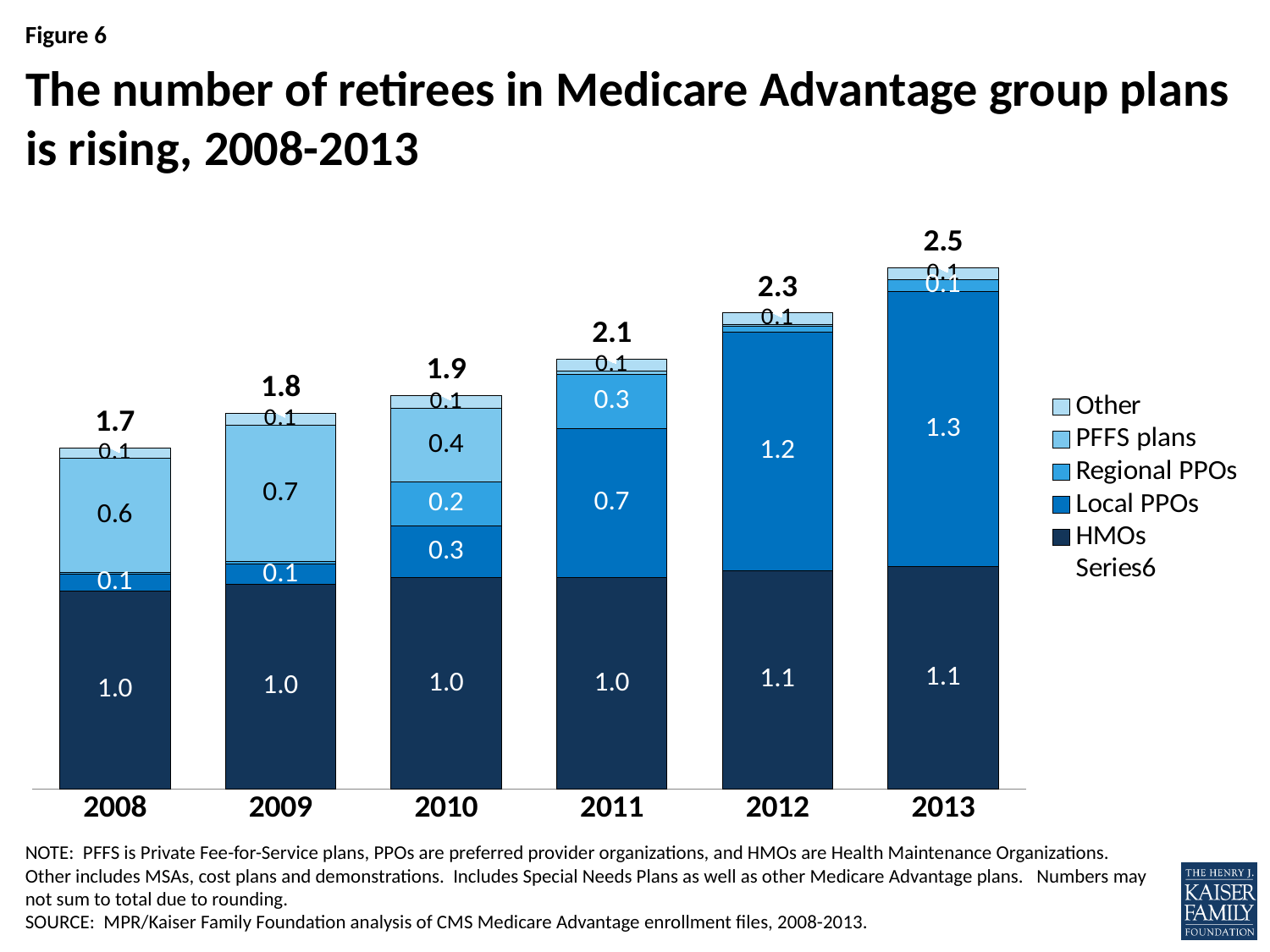
What is the total shown above the bar for 2008? 1.7 What is the value for PFFS plans in 2009? 0.7 Which year has the highest total number of retirees? 2013 What is the total number of retirees in Medicare Advantage group plans shown for 2013? 2.5 Do the bar totals rise or fall from 2008 to 2013? rise How many years are shown on the x axis? 6 Which year has the lowest total number of retirees? 2008 What is the value for Local PPOs in 2013? 1.3 What is the value for HMOs in 2011? 1.0 What is the difference between the total for 2013 and the total for 2008? 0.8 What is the value for Regional PPOs in 2010? 0.2 Which is larger in 2012, the value for HMOs or the value for Local PPOs? Local PPOs